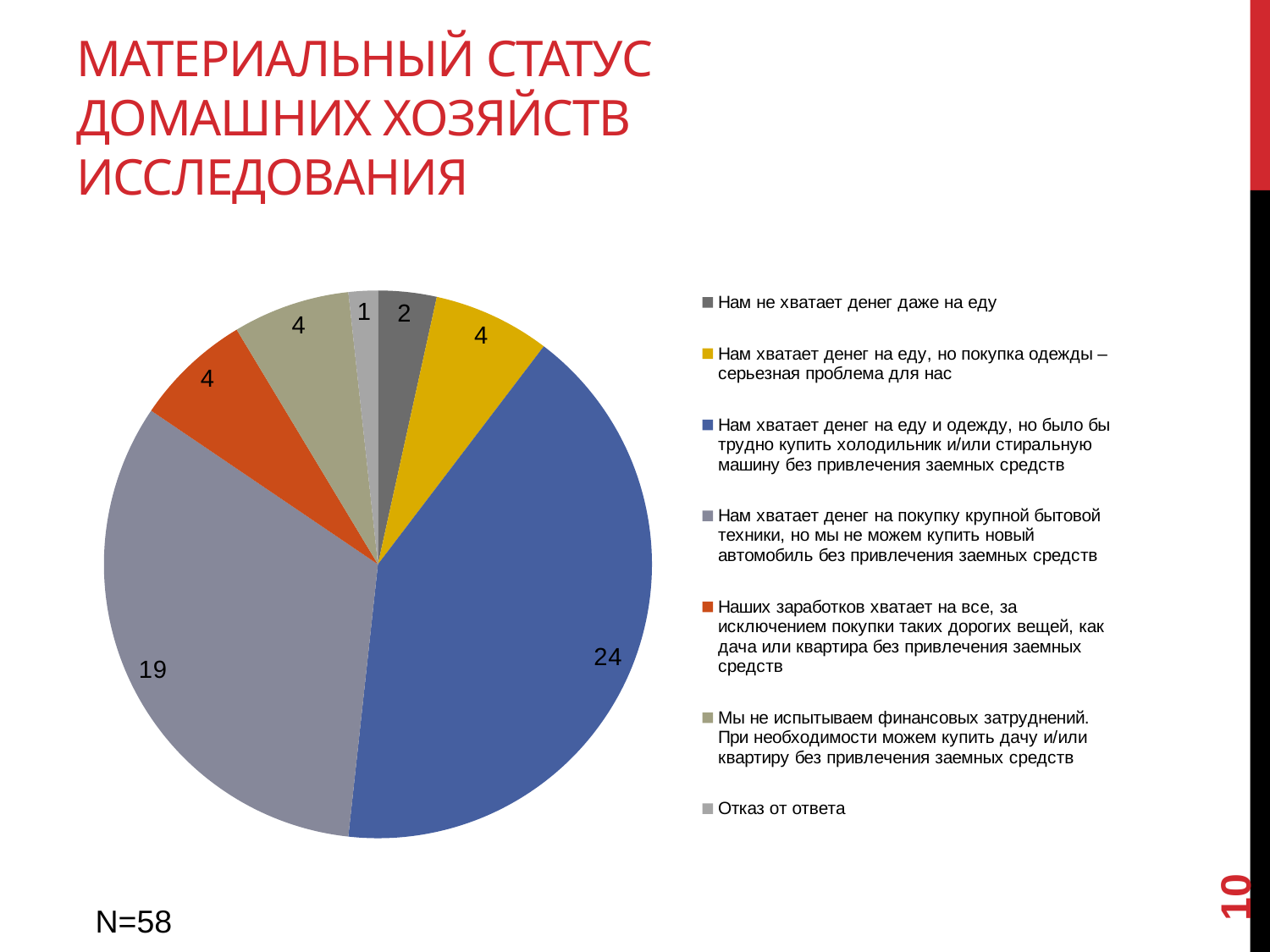
What sample size (N) is stated on the slide? N=58 How many slices does the pie chart have? 7 Which category has the smallest slice of the pie? Отказ от ответа Which category has the largest slice of the pie? Нам хватает денег на еду и одежду, но было бы трудно купить холодильник и/или стиральную машину без привлечения заемных средств What is the difference between the two largest slices (24 and 19)? 5 What is the value for "Нам хватает денег на еду и одежду, но было бы трудно купить холодильник и/или стиральную машину без привлечения заемных средств"? 24 How many entries does the legend list? 7 What is the value for "Отказ от ответа"? 1 Which is larger: the slice for "Нам не хватает денег даже на еду" or the slice for "Нам хватает денег на еду, но покупка одежды – серьезная проблема для нас"? Нам хватает денег на еду, но покупка одежды – серьезная проблема для нас What kind of chart is shown on the slide? pie chart What is the value for "Нам хватает денег на покупку крупной бытовой техники, но мы не можем купить новый автомобиль без привлечения заемных средств"? 19 What is the value for "Нам не хватает денег даже на еду"? 2